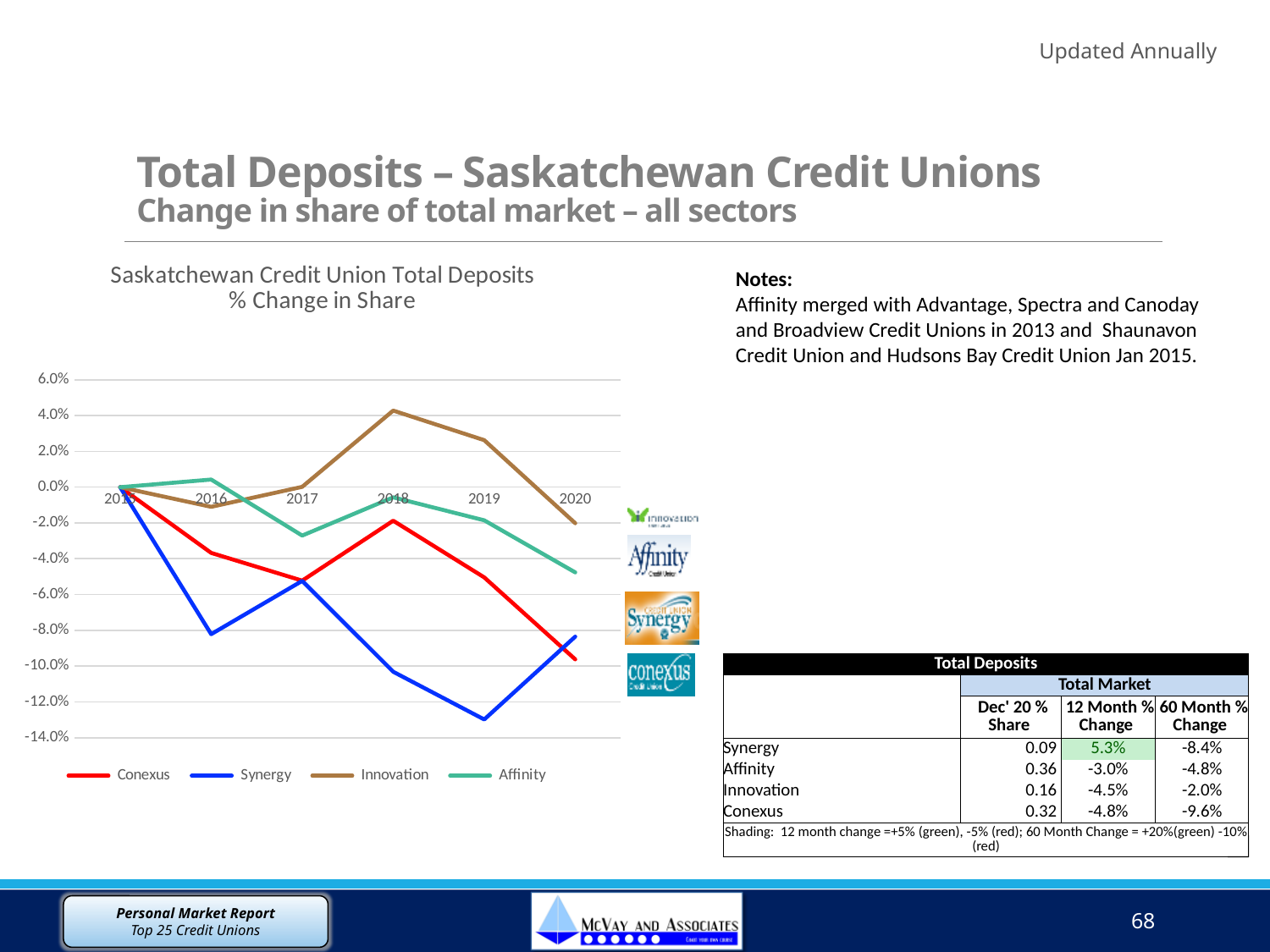
How many series does the chart legend list? 4 Which series has the highest value in 2018? Innovation What is the title of the chart? Saskatchewan Credit Union Total Deposits % Change in Share How many years are plotted along the x axis of the chart? 6 Does the Synergy line rise or fall from 2015 to 2019? fall Which series has the lowest value in 2016? Synergy Which series has the lowest value in 2019? Synergy What kind of chart is shown on the slide? line chart Is the value for Innovation in 2018 greater or less than 2.0%? greater Is the value for Synergy in 2019 greater or less than -12.0%? less Is the value for Conexus in 2016 greater or less than -2.0%? less In 2018, which is larger, the value for Conexus or the value for Synergy? Conexus